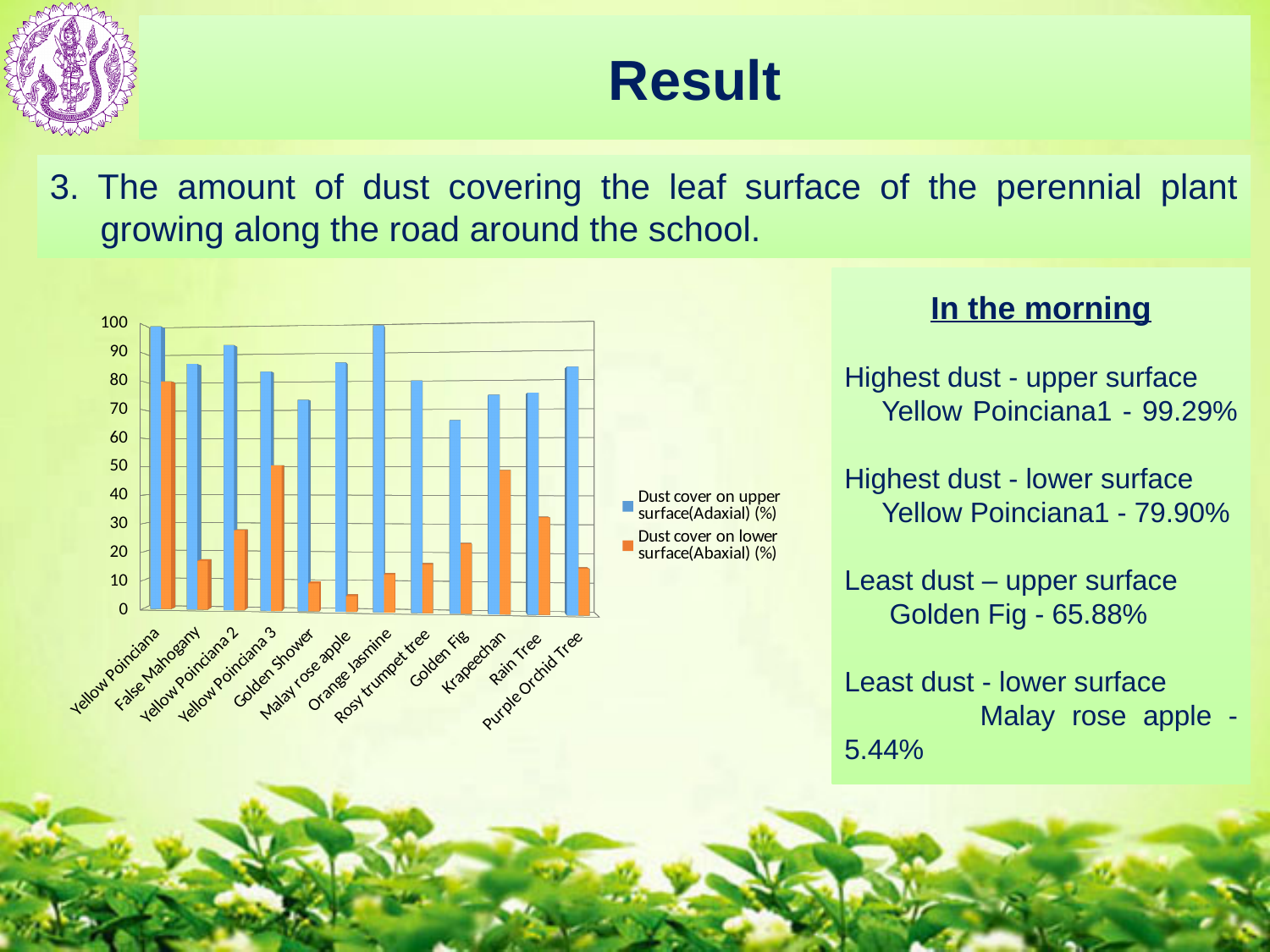
According to the slide, what is the dust cover on the lower surface for Malay rose apple? 5.44% Is the dust cover on the lower surface for False Mahogany greater or less than 20? less How many series does the chart legend list? 2 What is the difference between the upper surface (99.29%) and lower surface (79.90%) dust cover for Yellow Poinciana1? 19.39% What kind of chart is shown on the slide? bar chart Which plant has the lowest dust cover on the lower surface (Abaxial)? Malay rose apple According to the slide, what is the dust cover on the upper surface for Yellow Poinciana1? 99.29% Which has a higher dust cover on the upper surface, Yellow Poinciana 2 or Yellow Poinciana 3? Yellow Poinciana 2 Which plant has the highest dust cover on the lower surface (Abaxial)? Yellow Poinciana Which plant has the lowest dust cover on the upper surface (Adaxial)? Golden Fig How many plant categories are shown on the x axis of the chart? 12 Is the dust cover on the upper surface for Orange Jasmine greater or less than 90? greater